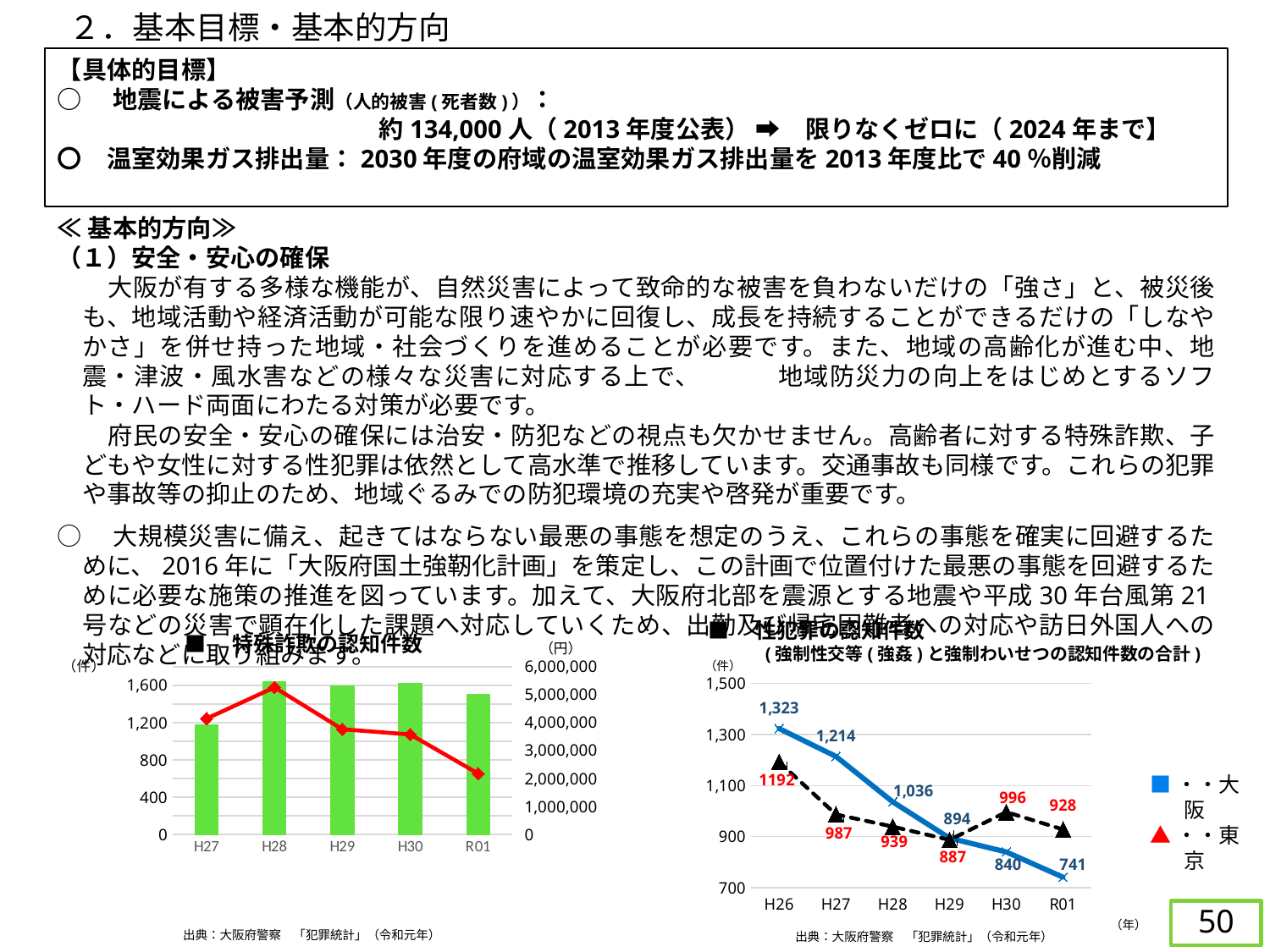
In the 性犯罪の認知件数 chart on the right, how many series does the legend list? 2 In the 特殊詐欺の認知件数 chart on the left, is the bar value for R01 greater or less than 1,200? greater In the 性犯罪の認知件数 chart on the right, what is the value for 東京 in H30? 996 In the 性犯罪の認知件数 chart on the right, does the 大阪 series rise or fall from H26 to R01? fall In the 特殊詐欺の認知件数 chart on the left, is the line value (円) for R01 greater or less than 3,000,000? less In the 性犯罪の認知件数 chart on the right, in which year is the 東京 value highest? H26 In the 性犯罪の認知件数 chart on the right, which is larger in H30, 大阪 or 東京? 東京 In the 性犯罪の認知件数 chart on the right, what is the difference between the 大阪 values in H26 and R01? 582 In the 特殊詐欺の認知件数 chart on the left, which year has the lowest bar? H27 In the 性犯罪の認知件数 chart on the right, what is the value for 大阪 in H26? 1,323 In the 性犯罪の認知件数 chart on the right, in which year is the 大阪 value lowest? R01 In the 性犯罪の認知件数 chart on the right, how many years are plotted on the x axis? 6